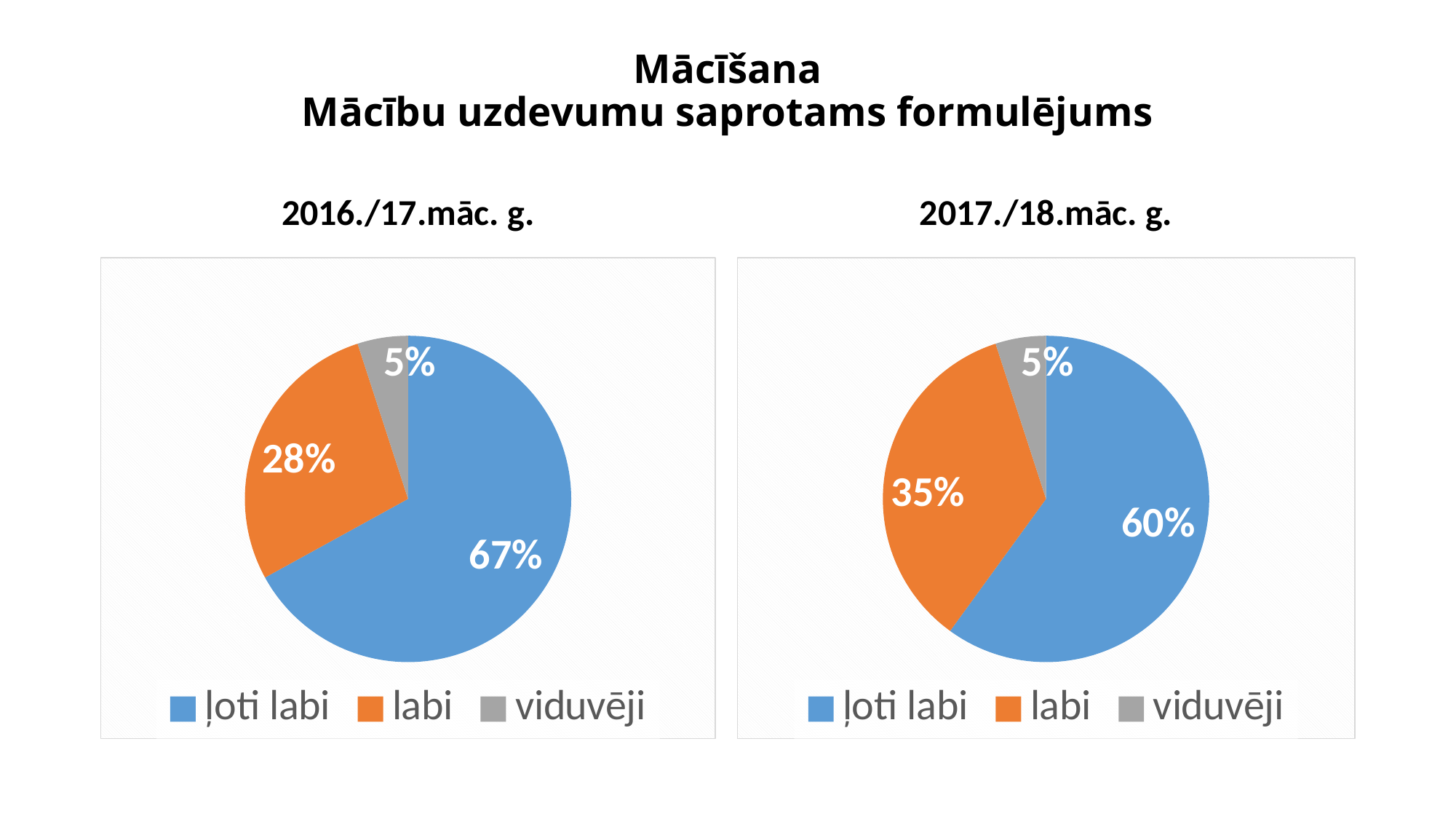
In the 2017./18.māc. g. chart, which colour represents 'viduvēji'? grey In the 2017./18.māc. g. chart, what share does 'labi' have? 35% How many categories does the 2016./17.māc. g. chart show? 3 In the 2017./18.māc. g. chart, which category has the smallest slice? viduvēji In the 2016./17.māc. g. chart, what is the value for 'viduvēji'? 5% What type of chart is the 2017./18.māc. g. chart? pie chart Which chart has the larger value for 'labi', 2016./17.māc. g. or 2017./18.māc. g.? 2017./18.māc. g. In the 2017./18.māc. g. chart, what is the difference between 'ļoti labi' and 'labi'? 25% In the 2016./17.māc. g. chart, what share does 'ļoti labi' have? 67% In the 2016./17.māc. g. chart, which category has the largest slice? ļoti labi In the 2016./17.māc. g. chart, what is the difference between 'ļoti labi' and 'labi'? 39% In the 2017./18.māc. g. chart, what is the value for 'ļoti labi'? 60%